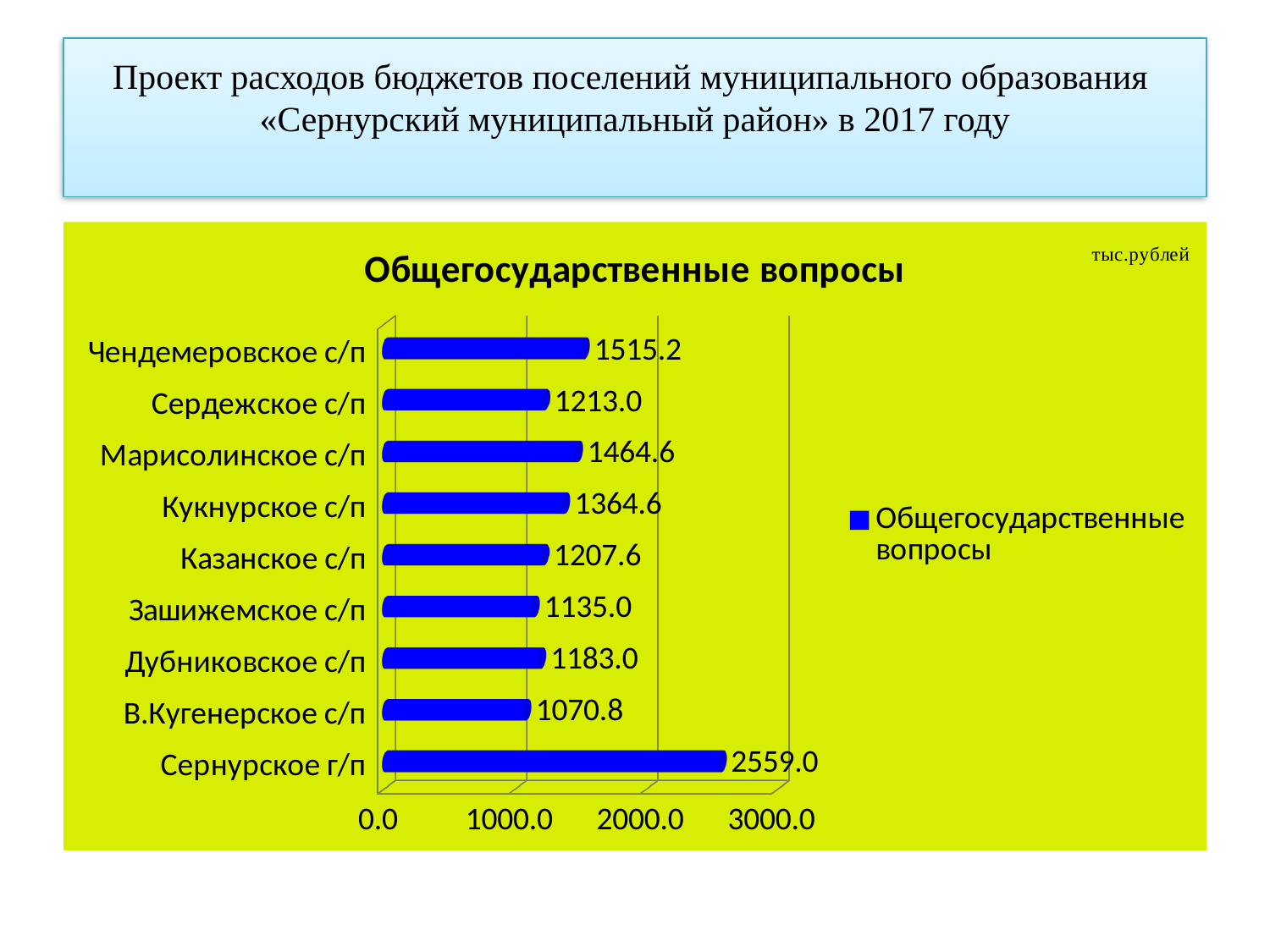
How many categories are shown in the chart? 9 What is the value for Казанское с/п? 1207.6 What kind of chart is shown? bar chart What is the value for Сернурское г/п? 2559.0 What is the value for Чендемеровское с/п? 1515.2 Is the value for Сердежское с/п greater or less than 1000.0? greater What is the title of the chart? Общегосударственные вопросы How many series does the legend list? 1 Which is larger, the value for Марисолинское с/п or Кукнурское с/п? Марисолинское с/п Which category has the highest value? Сернурское г/п What is the difference between the values for Сернурское г/п and В.Кугенерское с/п? 1488.2 Which category has the lowest value? В.Кугенерское с/п